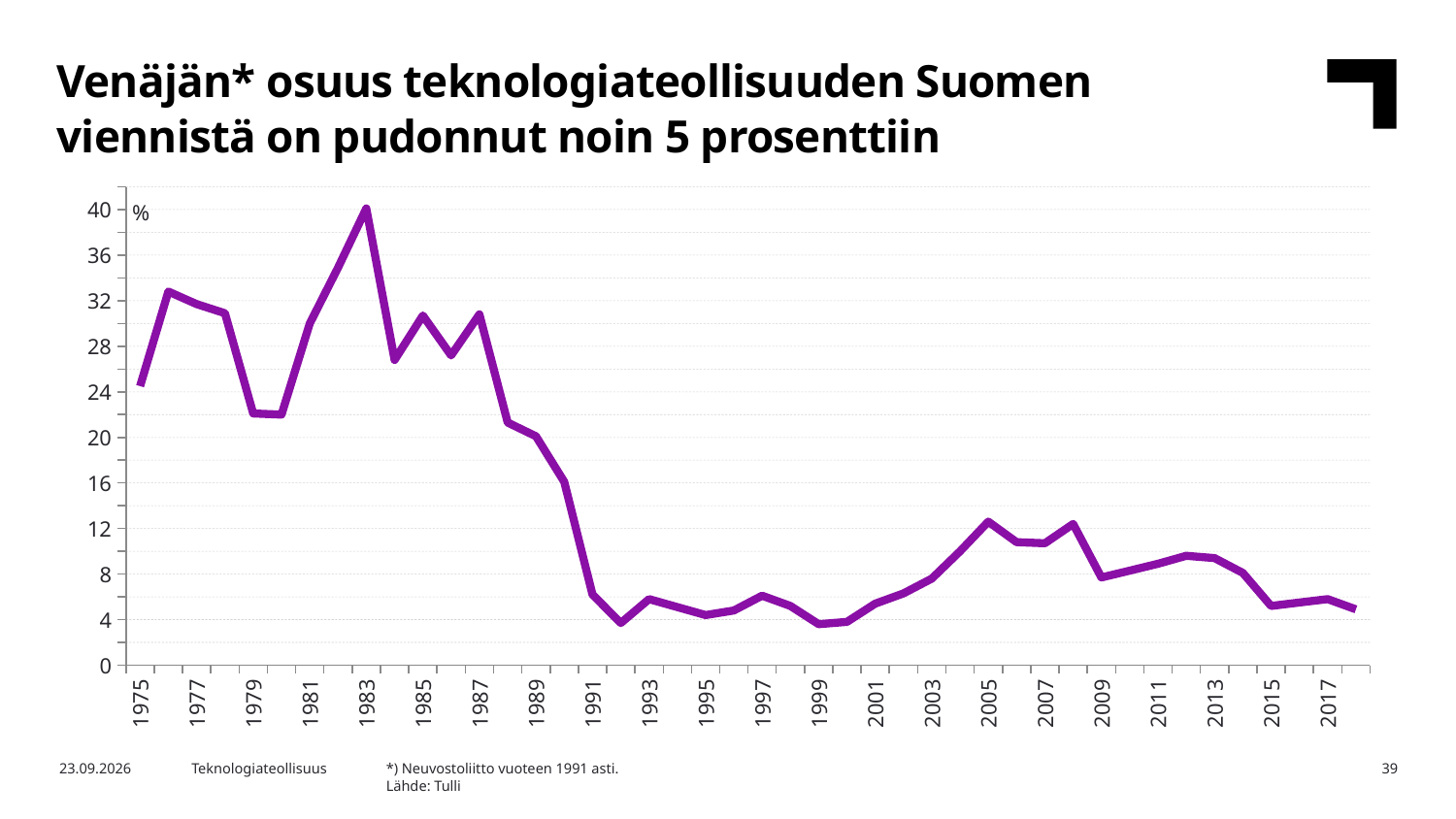
Is the value for 1979 greater or less than 24? less Is the value for 1975 greater or less than 20? greater Is the value for 1983 greater or less than 36? greater Which year has the larger value, 1977 or 1979? 1977 Which year has the larger value, 1983 or 2005? 1983 In which year does the line reach its highest value? 1983 Overall, does the line rise or fall from 1975 to the end of the series? fall What unit is shown at the top of the vertical axis? % What kind of chart is shown on the slide? line chart